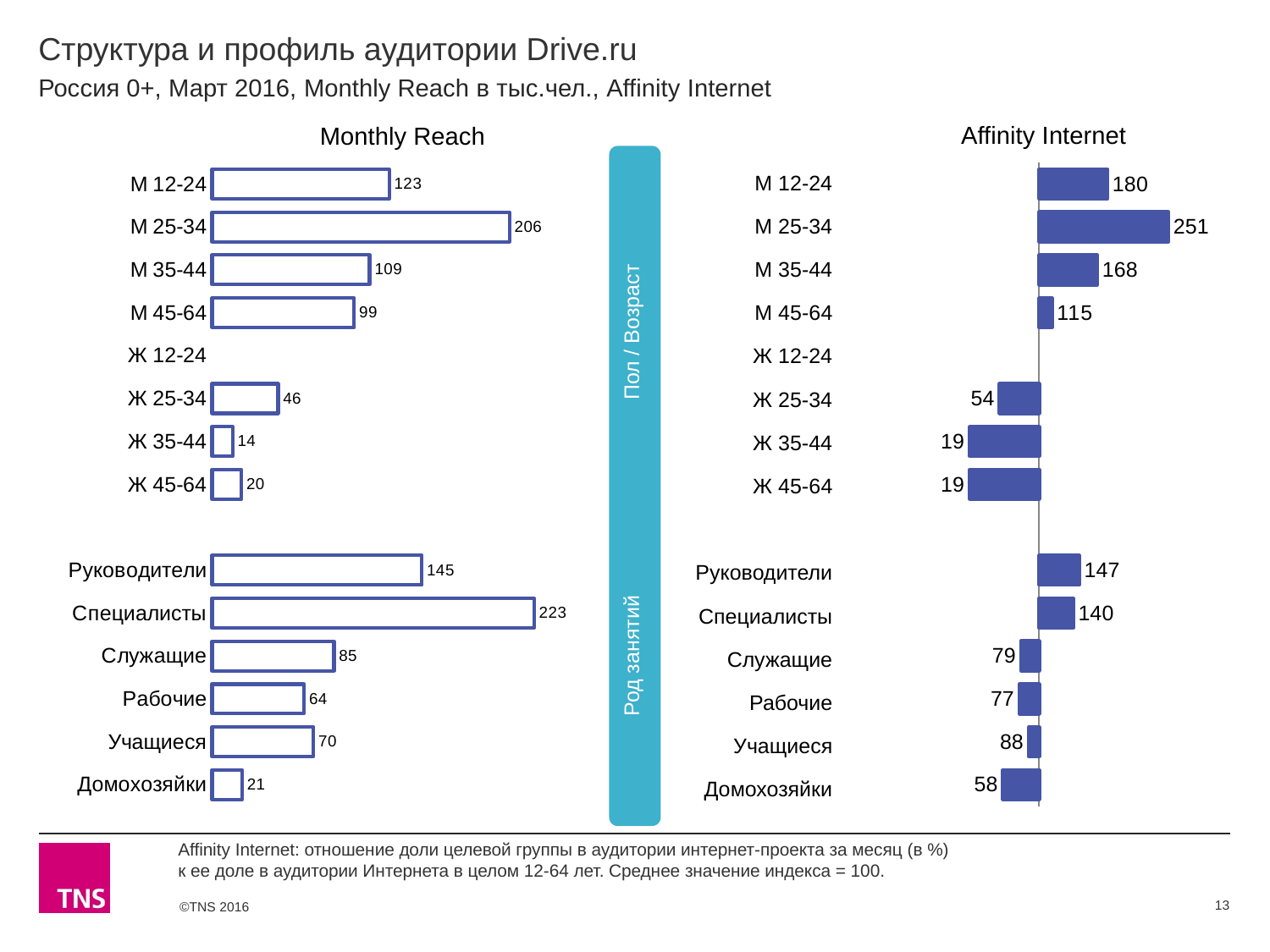
In the Monthly Reach chart, which category has the lowest labelled value? Ж 35-44 In the Affinity Internet chart, what is the value for Руководители? 147 In the Affinity Internet chart, what is the value for Домохозяйки? 58 In the Monthly Reach chart, what is the value for М 25-34? 206 In the Monthly Reach chart, what is the difference between the values for Специалисты and Руководители? 78 In the Monthly Reach chart, which category has the highest value? Специалисты In the Affinity Internet chart, which category has the highest value? М 25-34 In the Affinity Internet chart, what is the difference between the values for М 12-24 and М 45-64? 65 In the Affinity Internet chart, which is larger: the value for Учащиеся or the value for Служащие? Учащиеся In the Monthly Reach chart, which is larger: the value for Рабочие or the value for Учащиеся? Учащиеся What is the title of the chart on the left side of the slide? Monthly Reach What type of chart is the Affinity Internet chart? Bar chart